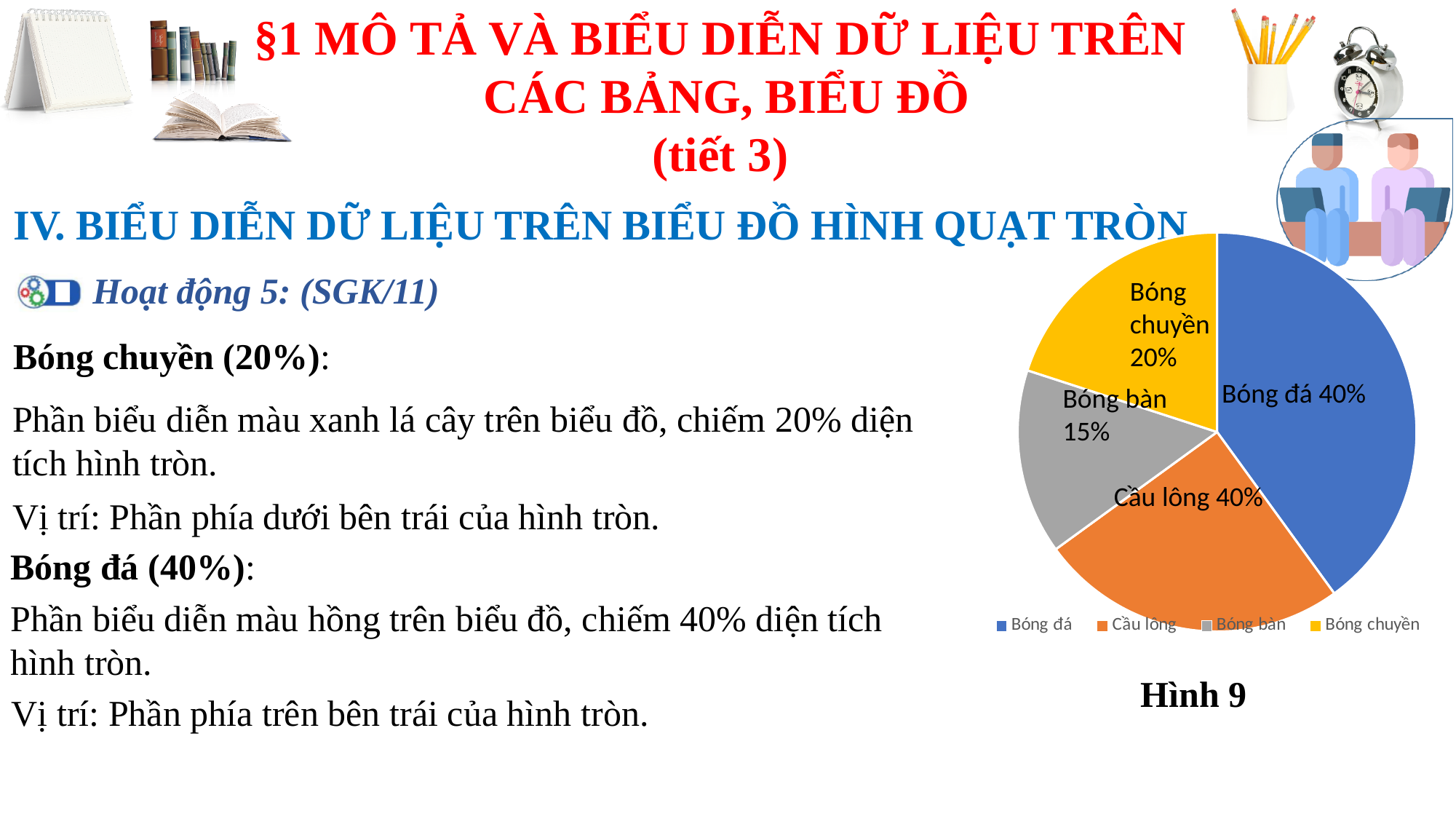
Which category has the smallest slice in the pie chart? Bóng bàn What percentage does the Bóng đá slice show in the pie chart? 40% What is the difference in percentage points between the Bóng đá slice and the Bóng bàn slice? 25 What percentage is labelled on the Bóng chuyền slice? 20% What percentage is labelled on the Cầu lông slice? 40% What colour is the Bóng chuyền slice in the pie chart? Yellow What type of chart is shown on the slide? Pie chart How many entries does the legend of the pie chart list? 4 Which slice is larger, Bóng đá or Bóng bàn? Bóng đá What percentage is labelled on the Bóng bàn slice? 15% Which slice is larger, Bóng chuyền or Bóng bàn? Bóng chuyền How many slices does the pie chart have? 4